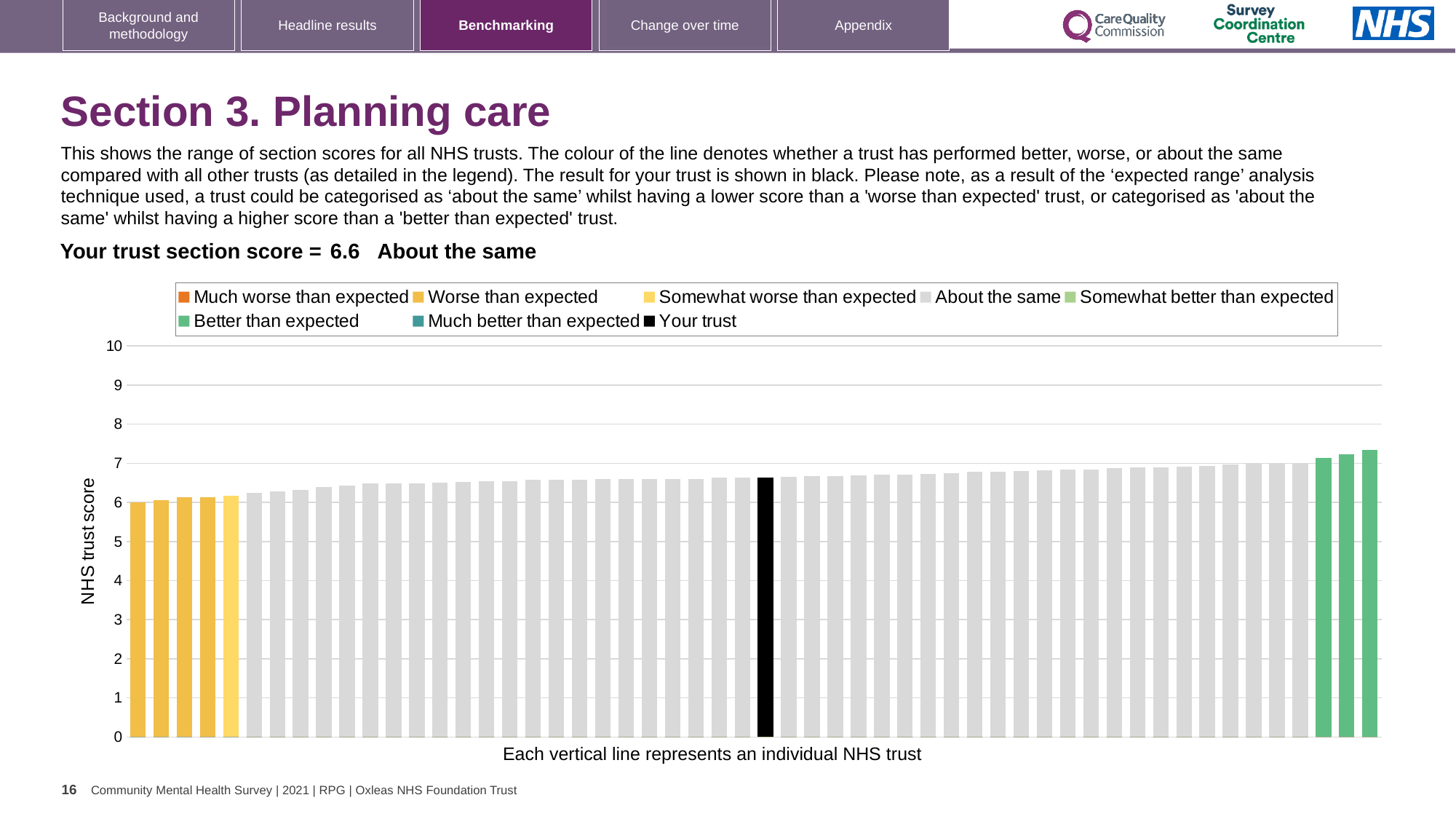
What is the section score for your trust shown on the slide? 6.6 Is the value for the highest bar on the chart greater or less than 7? greater How many entries does the chart legend list? 8 What is the label on the vertical axis of the chart? NHS trust score Is the value for the lowest bar on the chart greater or less than 7? less Do the trust scores rise or fall from left to right along the x axis? rise What is the highest value shown on the vertical axis of the chart? 10 What colour is used for your trust's bar in the chart? black What kind of chart is shown on the slide? bar chart Is the value for your trust (the black bar) greater or less than 6? greater Which category is your trust placed in for this section? About the same How many bars are coloured green (better than expected) on the chart? 3